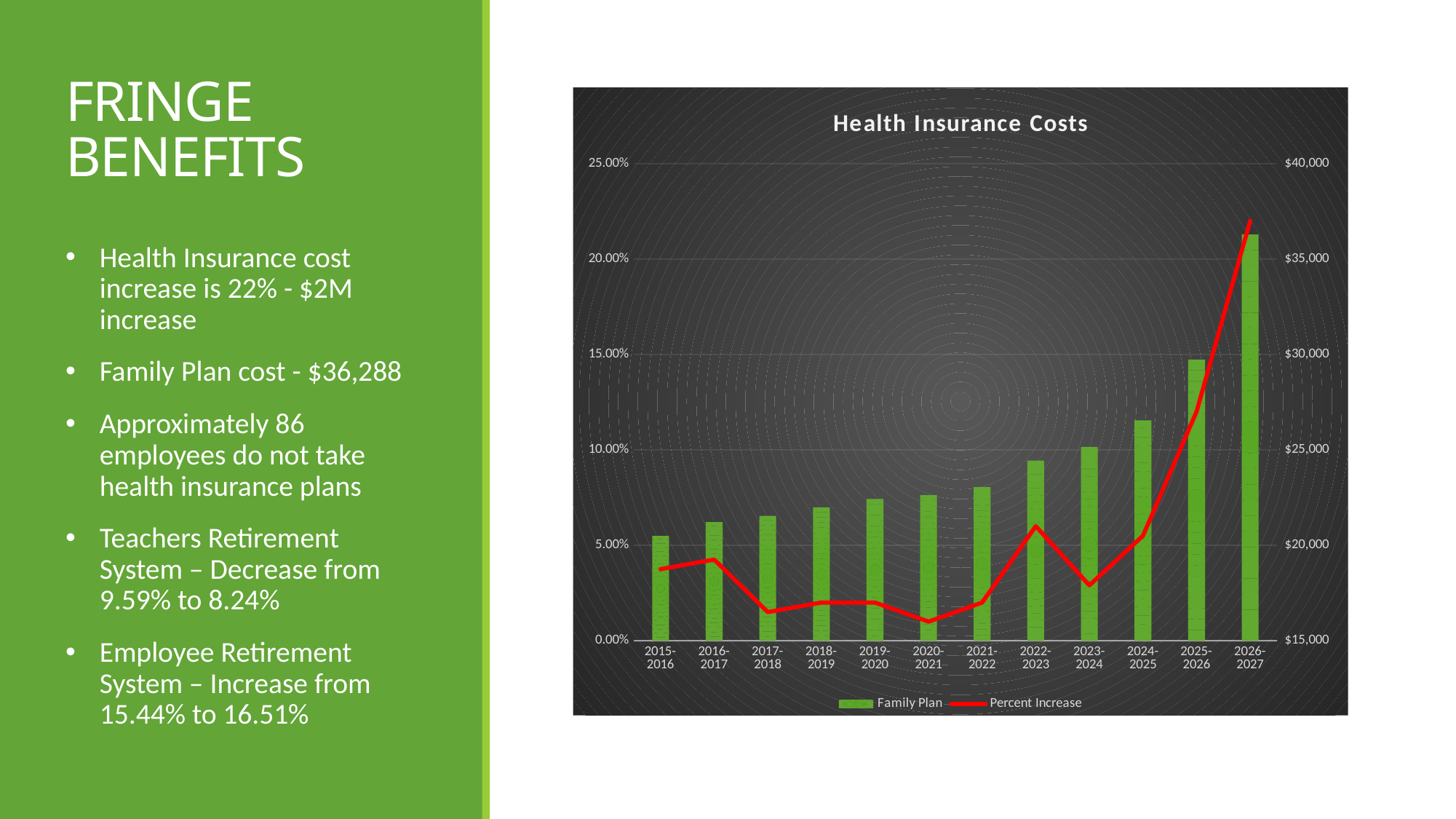
Which year has the highest Family Plan bar? 2026-2027 Is the Percent Increase value for 2020-2021 greater or less than 5.00%? less Is the Family Plan value for 2026-2027 greater or less than $35,000? greater Which year has the larger Percent Increase, 2022-2023 or 2023-2024? 2022-2023 Do the Family Plan bars rise or fall from 2015-2016 to 2026-2027? rise How many series does the chart legend list? 2 What are the two series named in the legend? Family Plan and Percent Increase Which year has the lowest Family Plan bar? 2015-2016 Which year has the lowest point on the Percent Increase line? 2020-2021 What kind of chart is this? Combined bar and line chart What is the title of the chart? Health Insurance Costs How many school years are shown on the x axis? 12